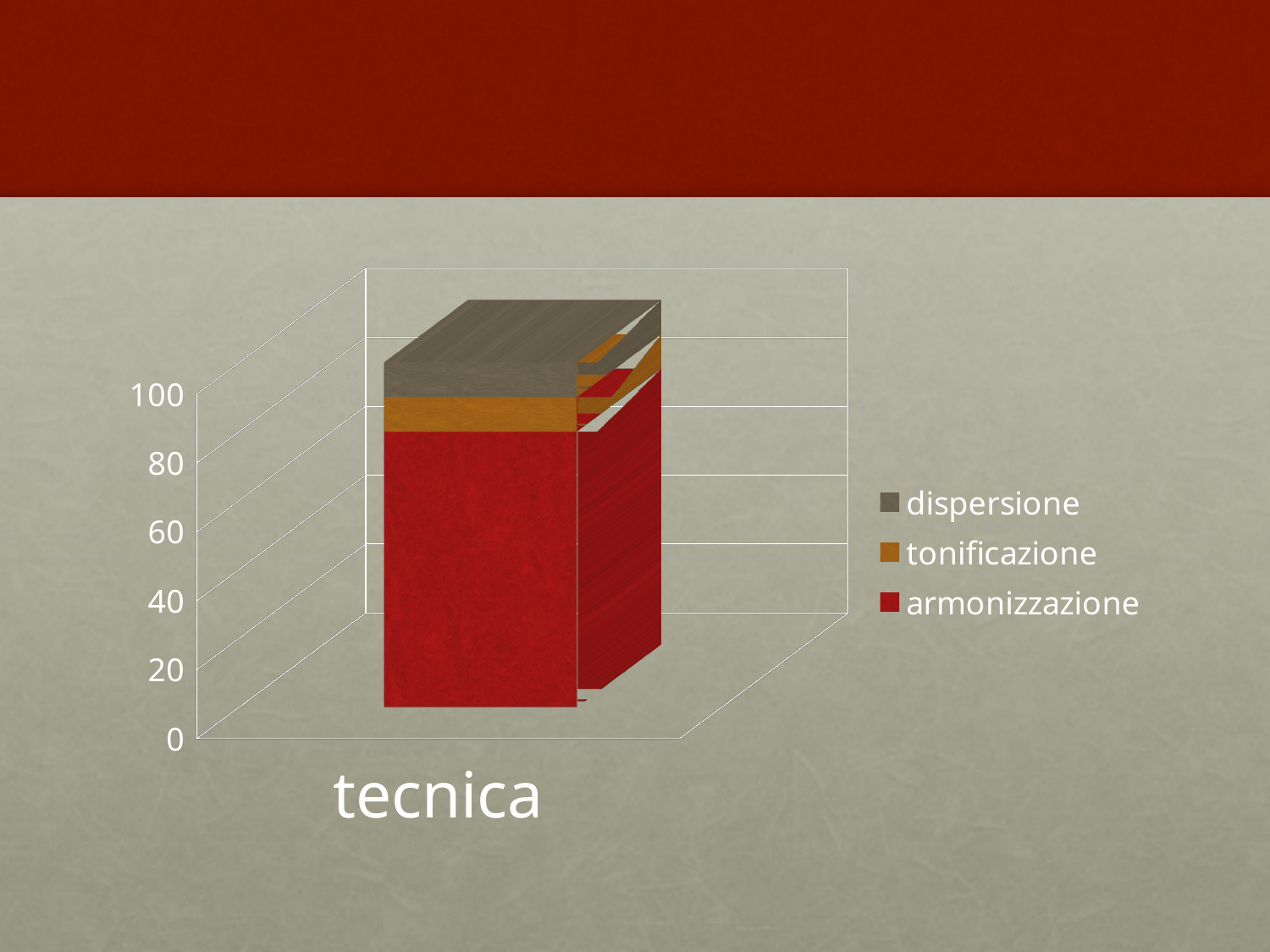
Is the value for dispersione in tecnica greater or less than 40? less Is the value for tonificazione in tecnica greater or less than 20? less Which is larger for tecnica, armonizzazione or tonificazione? armonizzazione Which series is shown in red in the legend? armonizzazione Which is larger for tecnica, armonizzazione or dispersione? armonizzazione What kind of chart is shown on the slide? Stacked bar chart What is the label of the category on the x axis? tecnica How many series does the legend list? 3 Is the value for armonizzazione in tecnica greater or less than 60? greater Which series makes up the largest part of the stacked bar for tecnica? armonizzazione How many categories are shown on the x axis? 1 What is the highest value shown on the vertical axis? 100